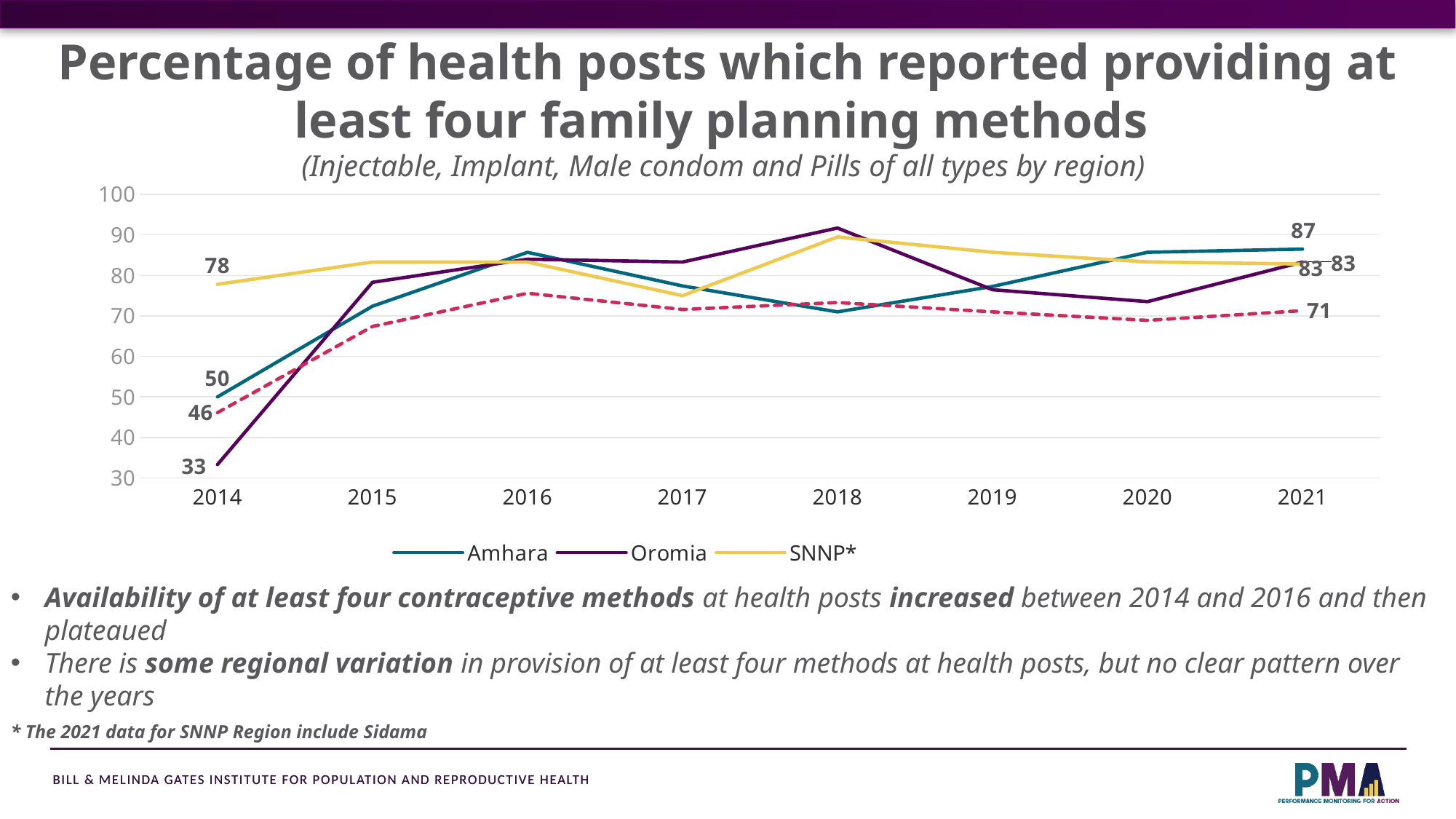
Did the value for Amhara rise or fall between 2014 and 2016? rise What was the value for Amhara in 2014? 50 What was the value for Oromia in 2014? 33 Is the value for Amhara in 2018 greater or less than 80? less How many years are shown on the x axis? 8 Which region had the highest value in 2021? Amhara What was the value for SNNP* in 2014? 78 By how much did the value for Amhara increase from 2014 to 2021? 37 What was the value for Amhara in 2021? 87 How many series does the legend list? 3 Which region had the lowest value in 2014? Oromia What kind of chart is shown on the slide? line chart